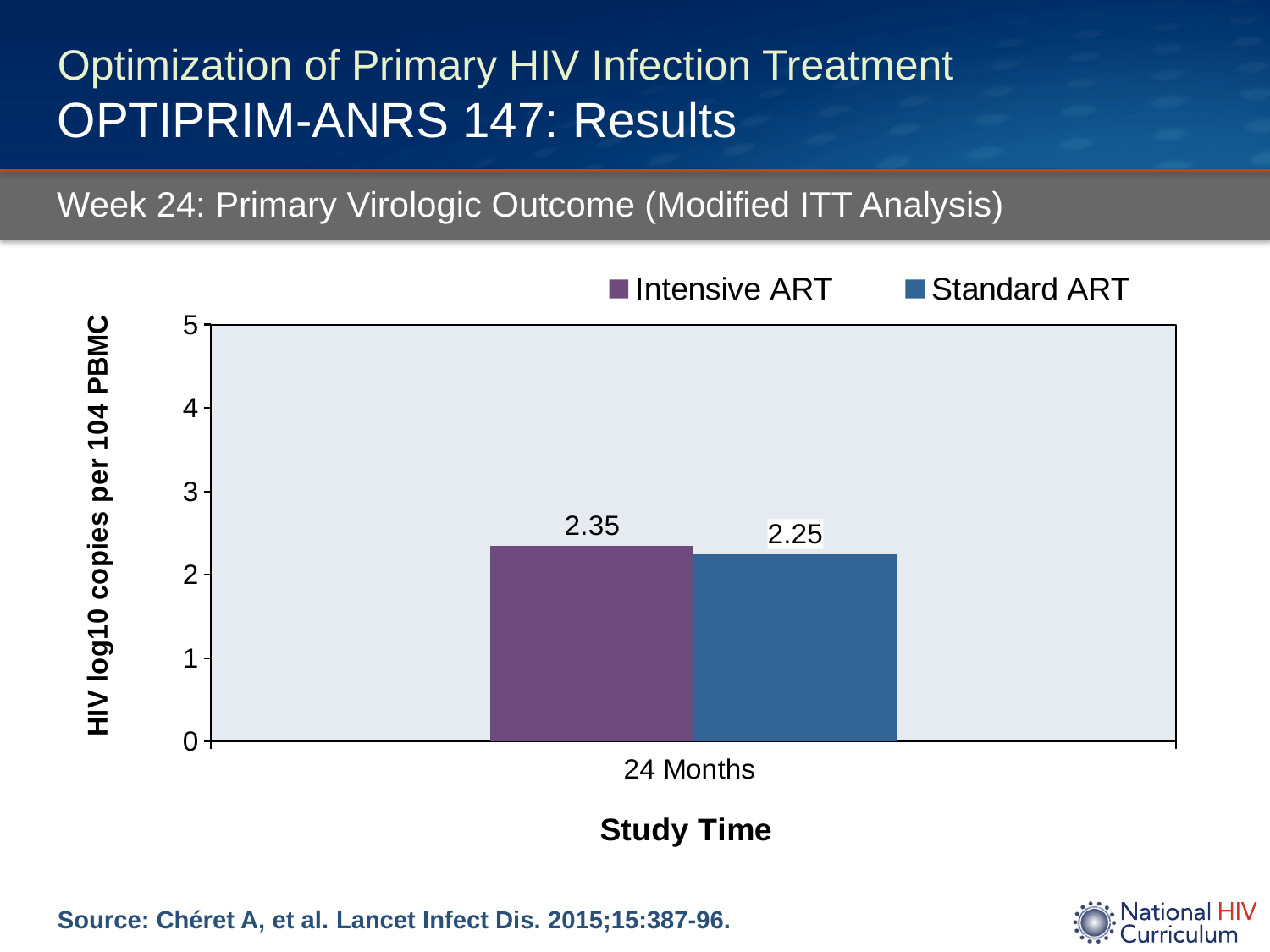
What is the value for Intensive ART at 24 Months? 2.35 Is the value for Intensive ART at 24 Months greater or less than 3? less What is the label of the y axis? HIV log10 copies per 104 PBMC How many categories are shown on the x axis? 1 What is the label of the x axis? Study Time What is the maximum value shown on the y axis? 5 What is the difference between the Intensive ART and Standard ART values at 24 Months? 0.10 How many series does the legend list? 2 Which series has the higher value at 24 Months, Intensive ART or Standard ART? Intensive ART Is the value for Standard ART at 24 Months greater or less than 2? greater What is the value for Standard ART at 24 Months? 2.25 What kind of chart is shown on the slide? Bar chart